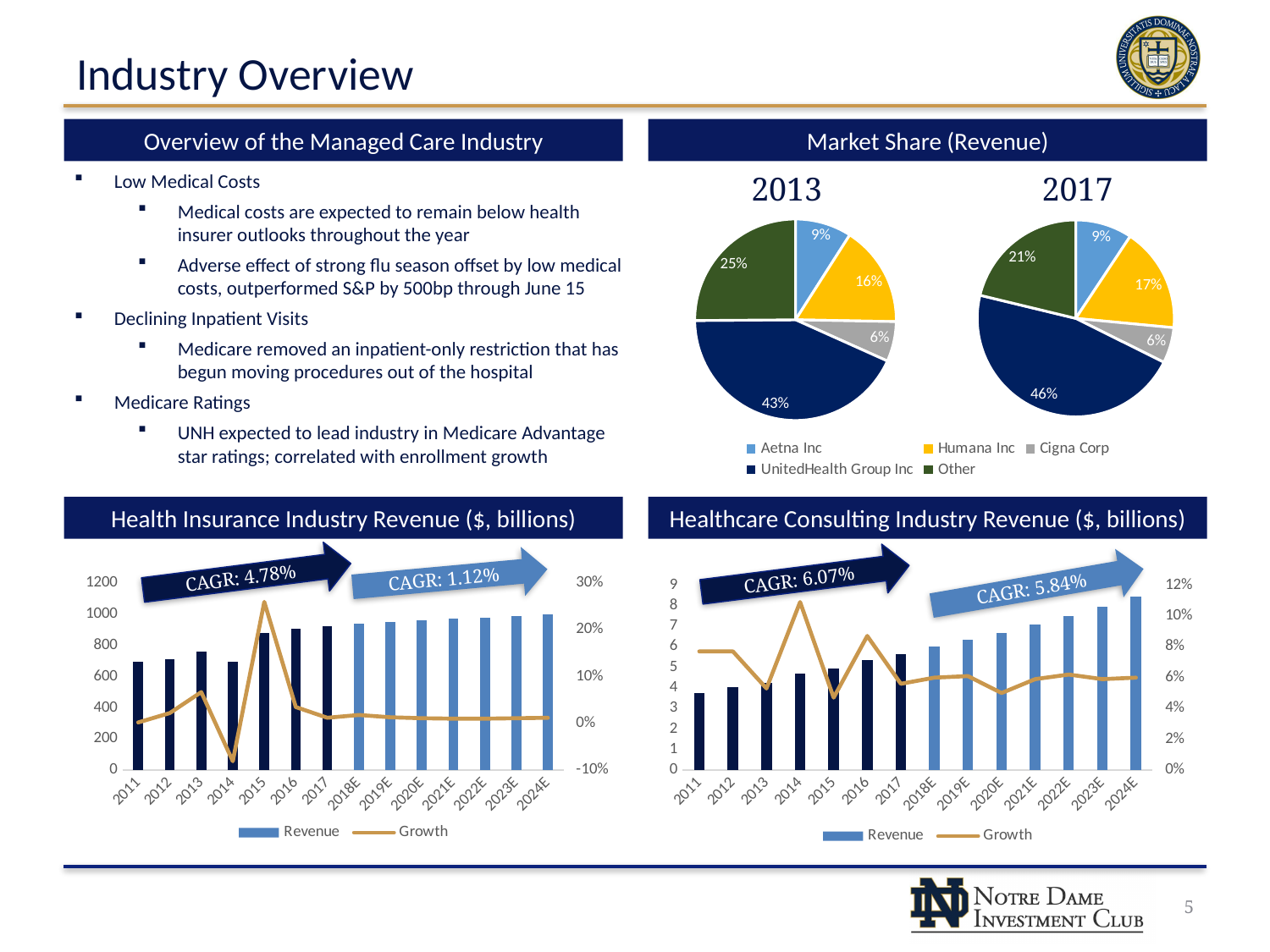
In the 2013 Market Share (Revenue) pie chart, what share does UnitedHealth Group Inc hold? 43% In the 2017 Market Share (Revenue) pie chart, what share does Humana Inc hold? 17% By how many percentage points did the 'Other' share change from the 2013 pie chart to the 2017 pie chart? 4 percentage points (25% to 21%) In the 2013 Market Share (Revenue) pie chart, which company has the smallest share? Cigna Corp In the 2013 Market Share (Revenue) pie chart, is the share for Humana Inc larger or smaller than the share for Other? smaller In the Health Insurance Industry Revenue chart, is the revenue bar for 2011 greater or less than 800? less In the 2017 Market Share (Revenue) pie chart, which company has the largest share? UnitedHealth Group Inc In the Healthcare Consulting Industry Revenue chart, is the revenue bar for 2024E greater or less than 7? greater In the Health Insurance Industry Revenue chart, how many years are shown on the x axis? 14 What CAGR is shown for the projected period in the Healthcare Consulting Industry Revenue chart? CAGR: 5.84% In the Healthcare Consulting Industry Revenue chart, do the revenue bars rise or fall from 2011 to 2024E? rise How many entries does the legend of the Market Share (Revenue) pie charts list? 5